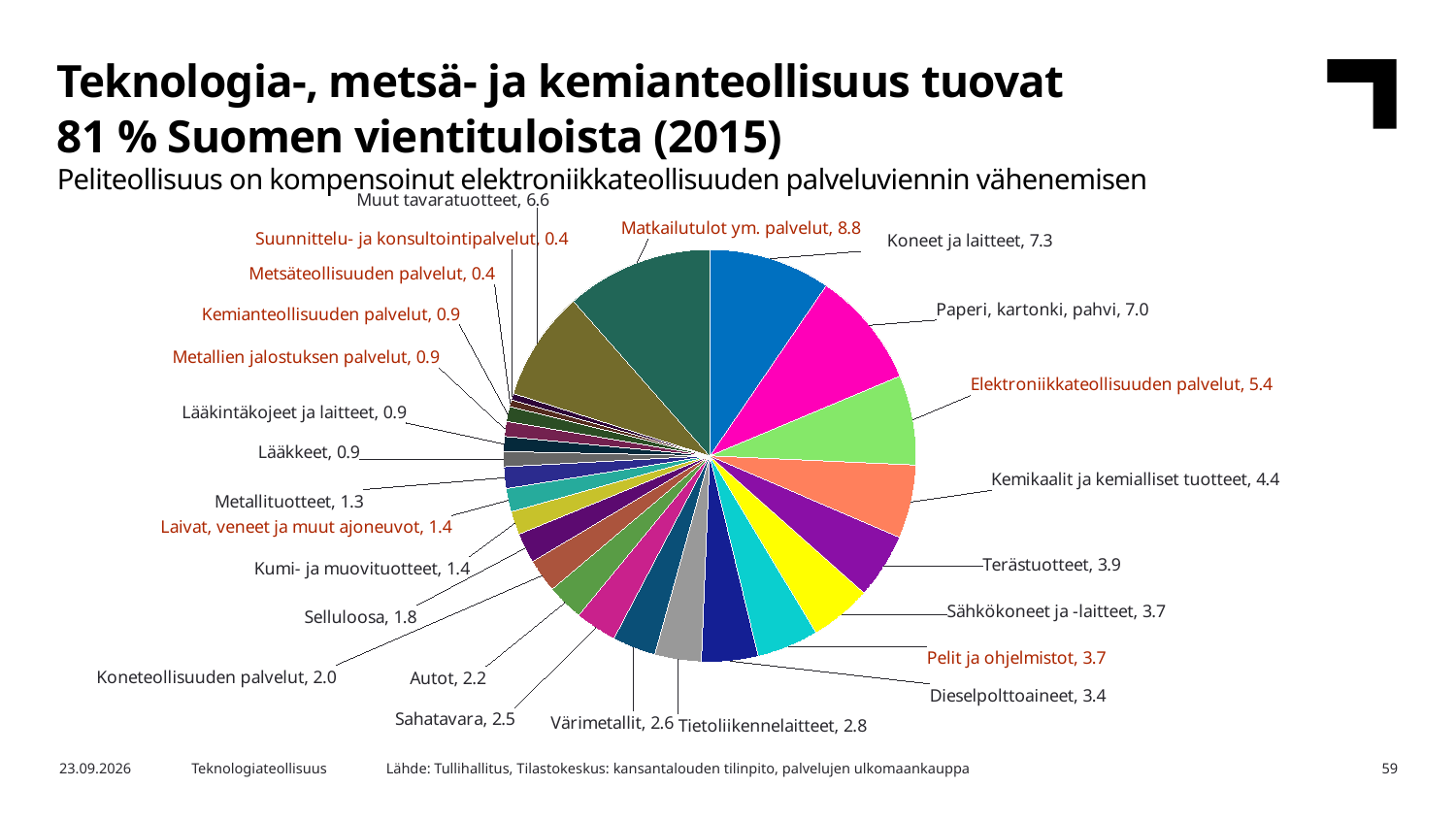
What is the value for Paperi, kartonki, pahvi? 7.0 How many categories are shown in the pie chart? 25 What is the value for Selluloosa? 1.8 What is the value for Pelit ja ohjelmistot? 3.7 Which is larger, Terästuotteet or Dieselpolttoaineet? Terästuotteet What is the smallest value shown in the pie chart? 0.4 Which category has the largest slice in the pie chart? Matkailutulot ym. palvelut What kind of chart is shown on the slide? pie chart What is the value for Matkailutulot ym. palvelut? 8.8 What is the difference between the values for Koneet ja laitteet and Paperi, kartonki, pahvi? 0.3 What is the title of the slide? Teknologia-, metsä- ja kemianteollisuus tuovat 81 % Suomen vientituloista (2015) What is the value for Muut tavaratuotteet? 6.6